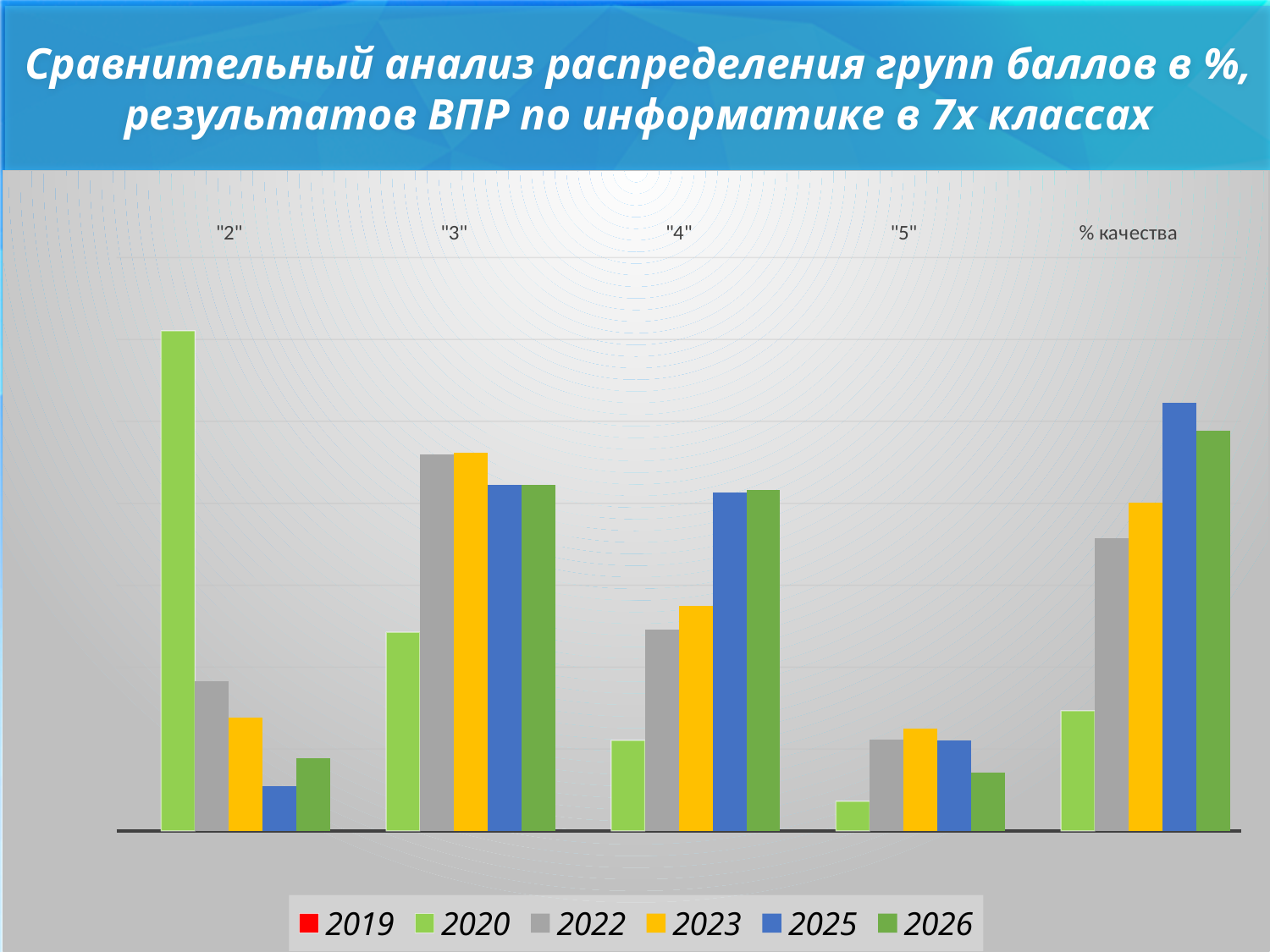
How many categories are shown along the x axis? 5 Which series has the highest value in the "% качества" category? 2025 In the "2" category, which is larger: the value for 2022 or for 2023? 2022 Across the categories "2", "3", "4" and "5", do the values for 2020 rise or fall? Fall How many series does the legend list? 6 In the "% качества" category, which is larger: the value for 2026 or for 2023? 2026 Which series has the lowest value in the "3" category? 2020 Which series has the lowest value in the "2" category? 2025 Which series has the lowest value in the "5" category? 2020 Which series has the highest value in the "2" category? 2020 What kind of chart is shown on the slide? Bar chart Which colour represents the 2023 series in the legend? Yellow